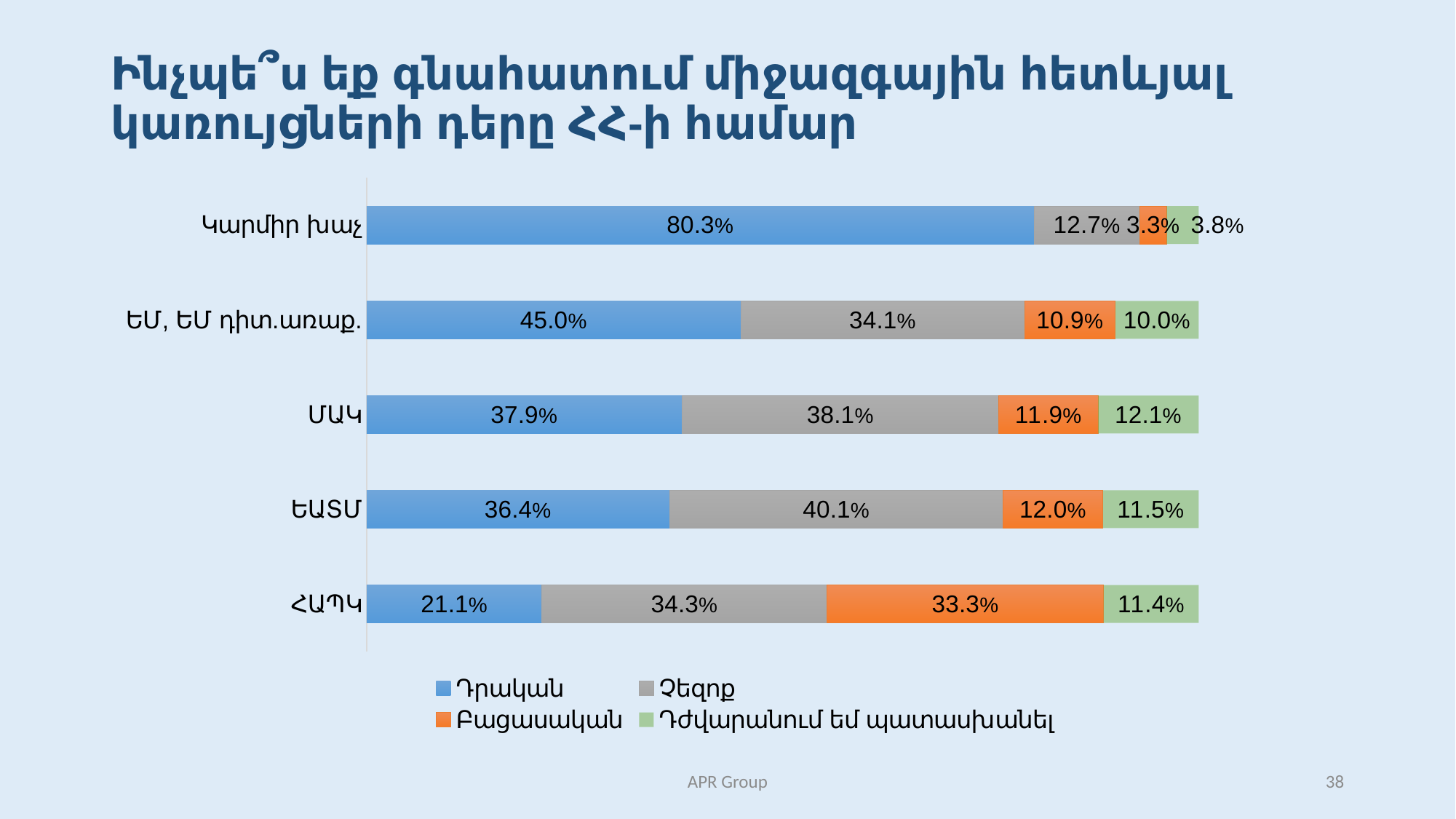
How many series does the legend list? 4 Which colour represents the Բացասական series? Orange What is the Դժվարանում եմ պատասխանել value for ՄԱԿ? 12.1% Which category has the lowest Դրական value? ՀԱՊԿ What is the Բացասական value for ՀԱՊԿ? 33.3% What is the Դրական value for Կարմիր խաչ? 80.3% What is the difference between the Դրական values for Կարմիր խաչ and ԵՄ, ԵՄ դիտ.առաք.? 35.3% What kind of chart is shown on the slide? Stacked bar chart What is the Չեզոք value for ԵԱՏՄ? 40.1% Which is larger: the Բացասական value for ՀԱՊԿ or the Բացասական value for ԵԱՏՄ? ՀԱՊԿ Which category has the highest Դրական value? Կարմիր խաչ How many categories are shown on the chart? 5